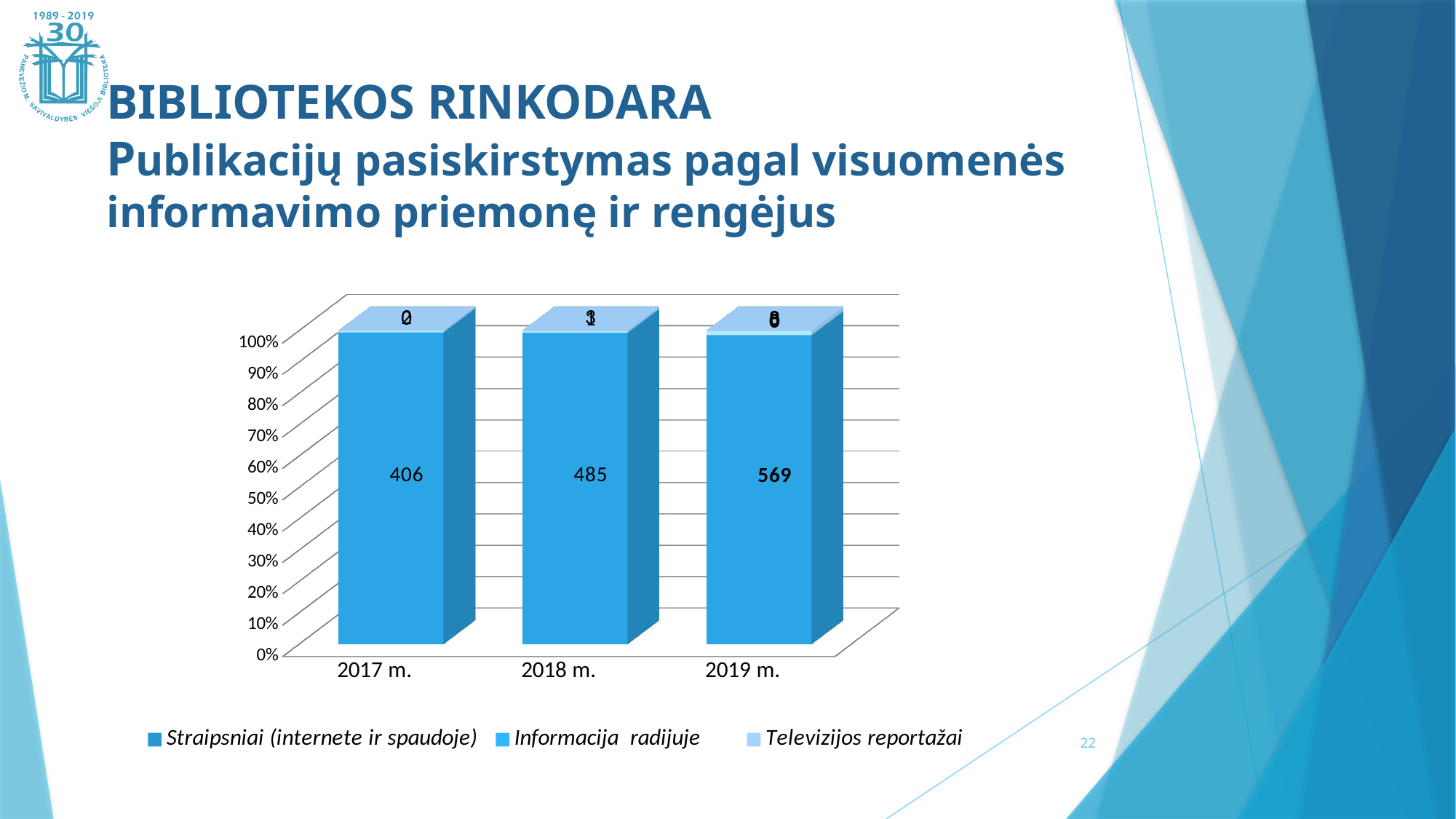
How many series does the legend list? 3 What is the value for Straipsniai (internete ir spaudoje) in 2017 m.? 406 Do the Straipsniai (internete ir spaudoje) values rise or fall from 2017 m. to 2019 m.? Rise How many years are shown on the x axis of the chart? 3 What is the value for Straipsniai (internete ir spaudoje) in 2019 m.? 569 Which year has the lowest value for Straipsniai (internete ir spaudoje)? 2017 m. What is the difference between the Straipsniai (internete ir spaudoje) values for 2018 m. and 2017 m.? 79 Which year has the highest value for Straipsniai (internete ir spaudoje)? 2019 m. Which is larger, the Straipsniai (internete ir spaudoje) value for 2018 m. or for 2019 m.? 2019 m. What is the difference between the Straipsniai (internete ir spaudoje) values for 2019 m. and 2017 m.? 163 What is the value for Straipsniai (internete ir spaudoje) in 2018 m.? 485 What kind of chart is shown on the slide? Stacked bar chart